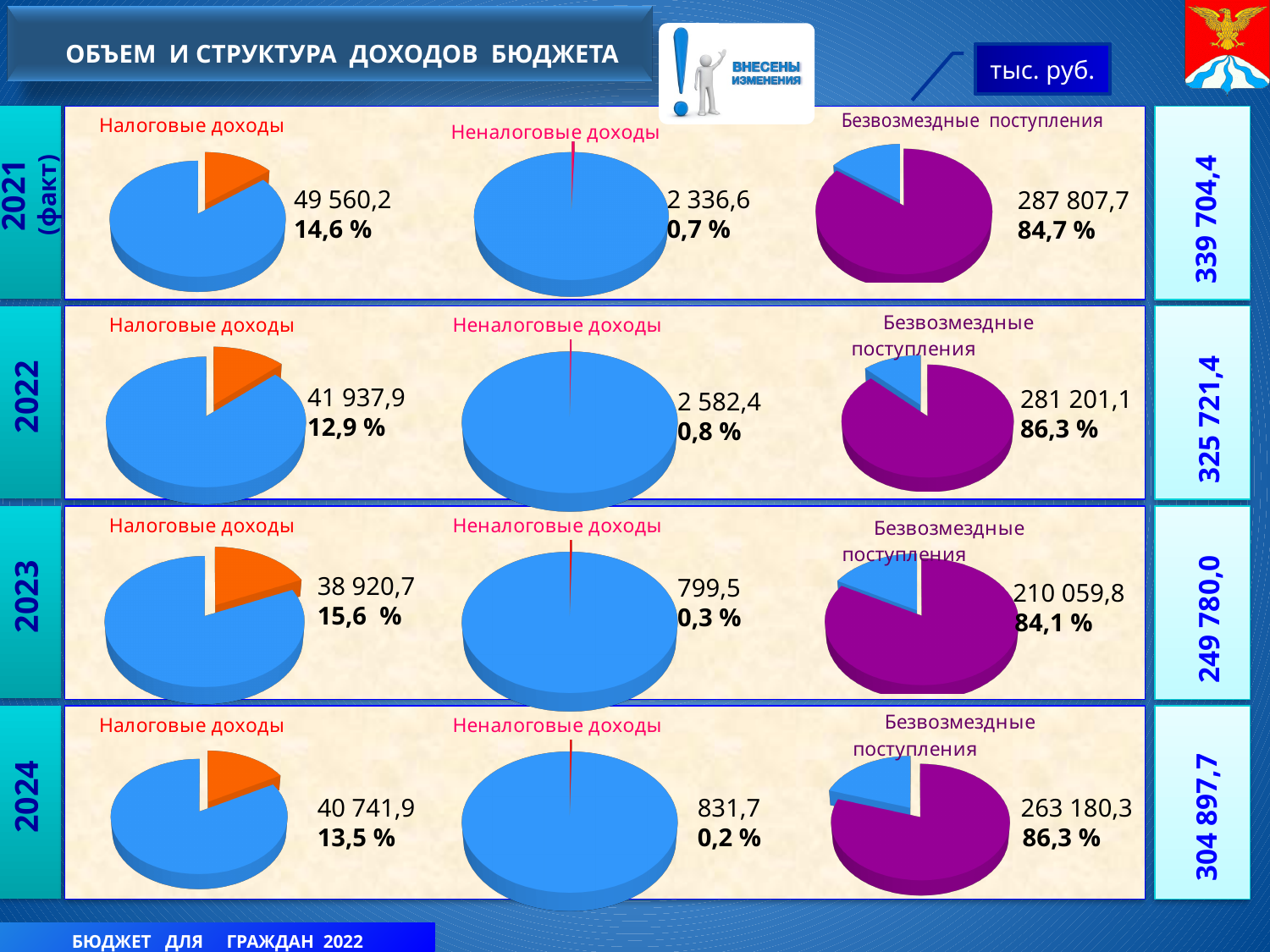
How many pie charts are shown on the slide? 12 In the 2021 (факт) row, what share does the 'Безвозмездные поступления' pie chart show for that category? 84,7 % Comparing the 'Налоговые доходы' pie charts for 2022 and 2023, which year shows the larger value? 2022 What is the difference between the 'Неналоговые доходы' values shown for 2024 and 2023? 32,2 In the 2024 row, what share does the 'Безвозмездные поступления' pie chart show for that category? 86,3 % What kind of charts are used on this slide? Pie charts In the 2021 (факт) row, what value is shown on the 'Налоговые доходы' pie chart? 49 560,2 In the 2022 row, what share does the 'Налоговые доходы' pie chart show for that category? 12,9 % In the 2022 row, what value is shown on the 'Неналоговые доходы' pie chart? 2 582,4 In the 2023 row, what value is shown on the 'Безвозмездные поступления' pie chart? 210 059,8 In the 2024 row, what value is shown on the 'Налоговые доходы' pie chart? 40 741,9